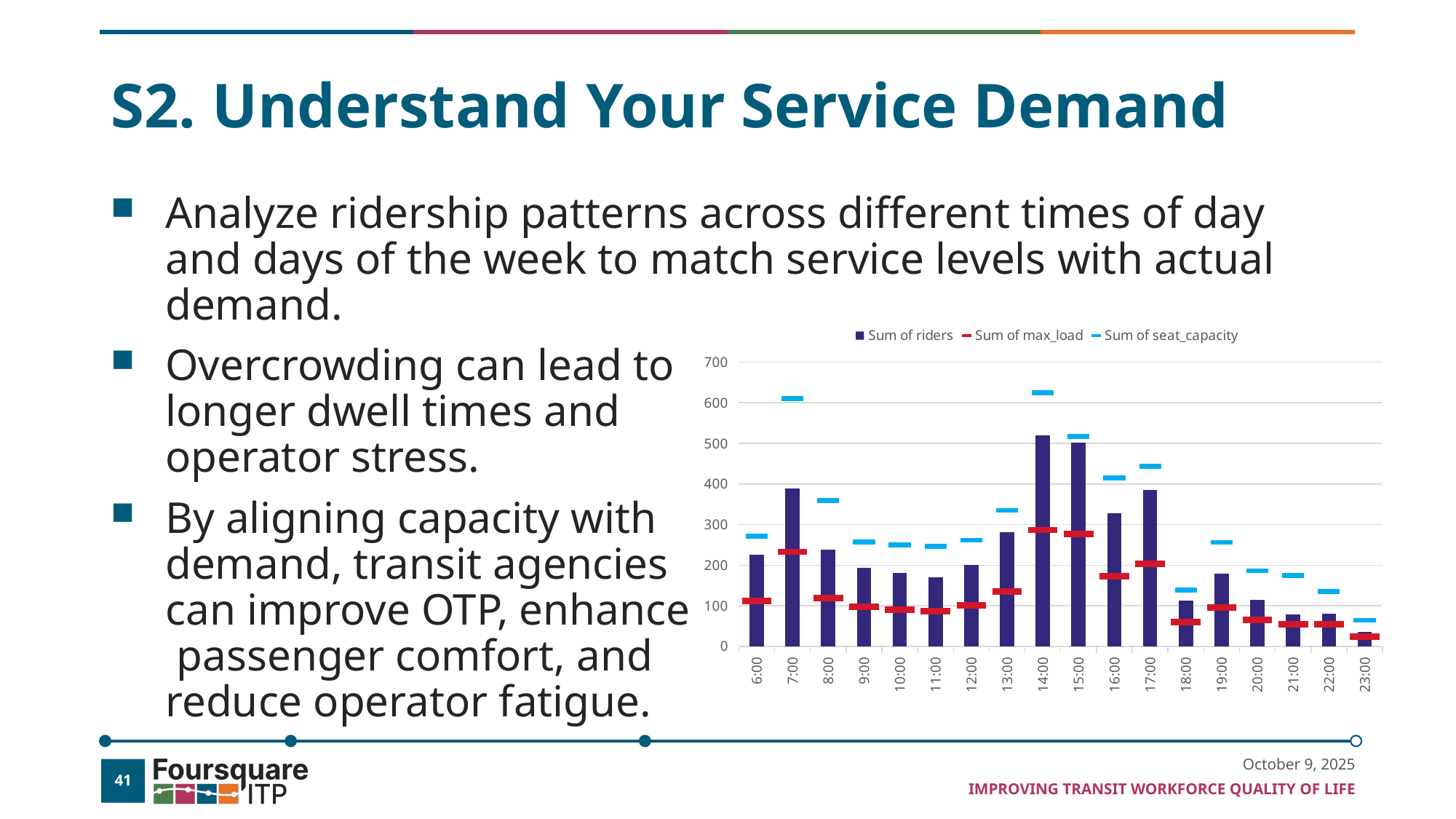
Is the Sum of riders at 6:00 greater or less than 200? greater At which hour is the Sum of riders bar lowest? 23:00 How many time-of-day categories are shown on the x axis? 18 At which hour is the Sum of max_load marker lowest? 23:00 At which hour is the Sum of riders bar highest? 14:00 Is the Sum of riders at 23:00 greater or less than 100? less Is the Sum of riders at 14:00 greater or less than 500? greater What kind of chart is shown on the slide? bar chart Do the Sum of riders values rise or fall from 14:00 to 23:00? fall How many series does the chart legend list? 3 Which series is shown as blue dashes in the chart? Sum of seat_capacity Which hour has a larger Sum of riders, 7:00 or 8:00? 7:00